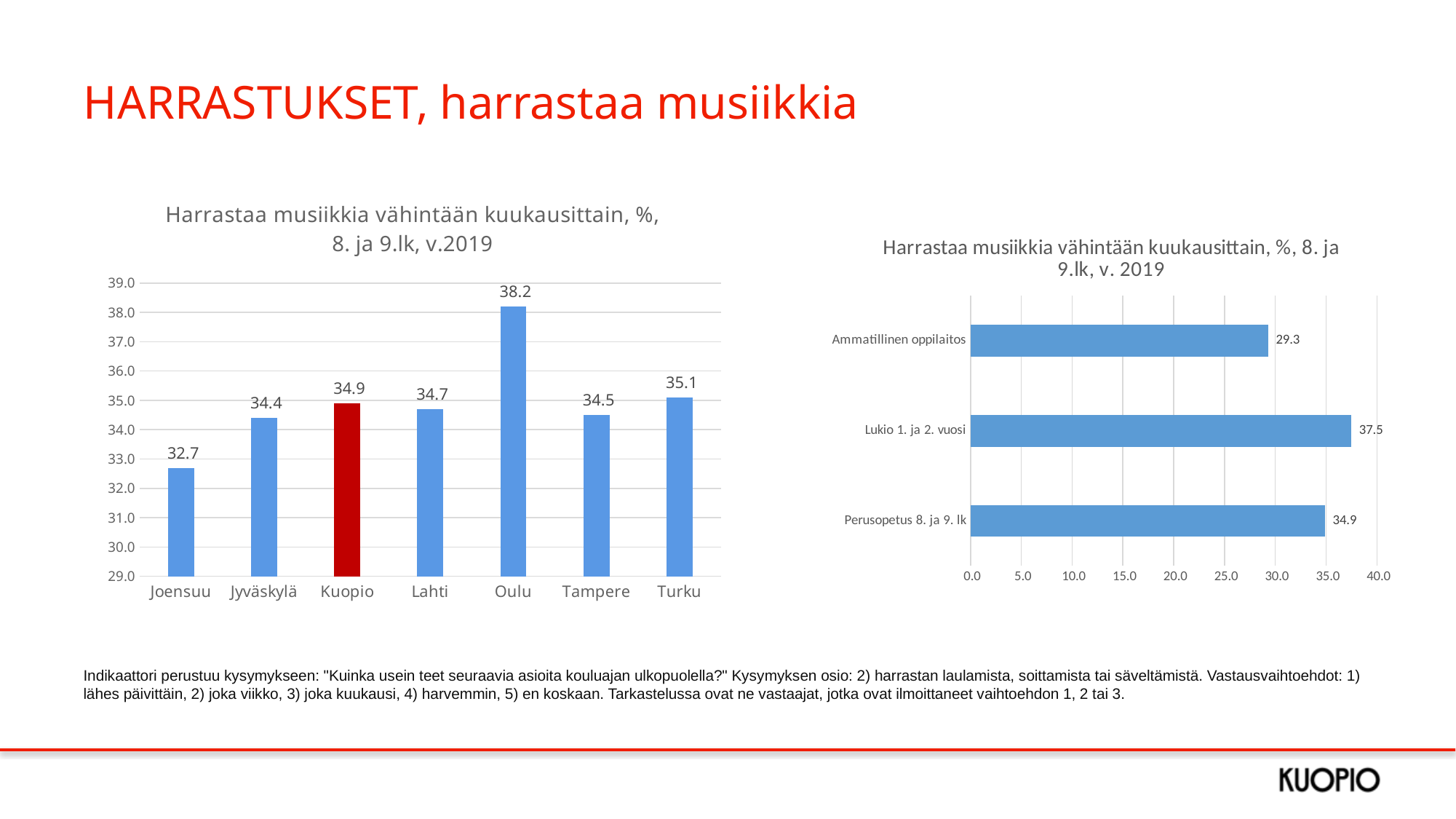
In the left chart (cities), how many cities are shown? 7 What kind of chart is the right chart (school types)? Bar chart In the right chart (school types), which category has the lowest value? Ammatillinen oppilaitos In the left chart (cities), which is larger, the value for Turku or the value for Jyväskylä? Turku In the left chart (cities), what is the difference between Oulu and Joensuu? 5.5 In the left chart (cities), which bar is coloured red? Kuopio In the right chart (school types), what is the value for Lukio 1. ja 2. vuosi? 37.5 In the left chart (cities), which city has the lowest value? Joensuu In the left chart (cities), what is the value for Oulu? 38.2 In the right chart (school types), what is the difference between Lukio 1. ja 2. vuosi and Ammatillinen oppilaitos? 8.2 In the left chart (cities), what is the value for Kuopio? 34.9 In the left chart (cities), which city has the highest value? Oulu